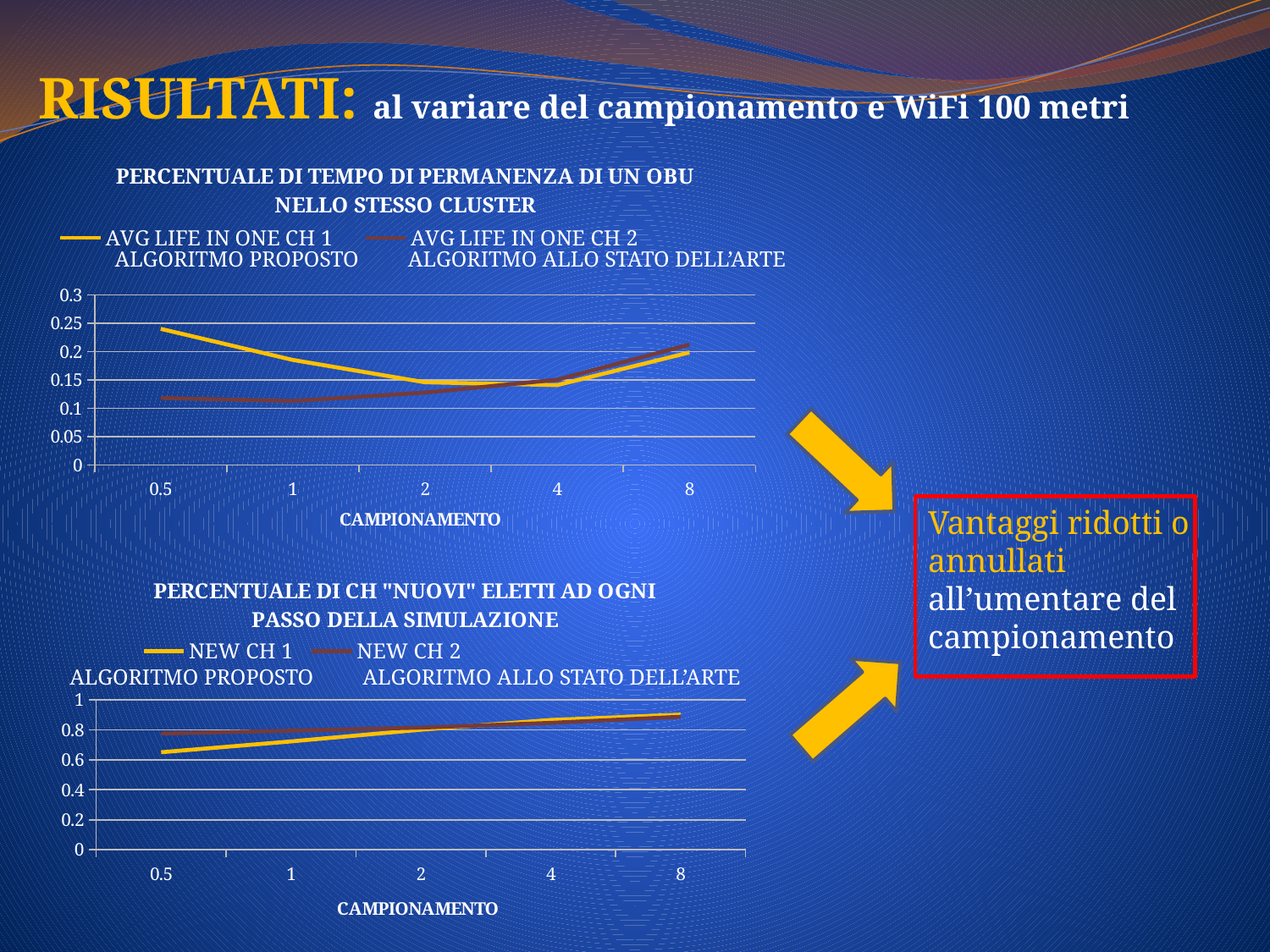
In the bottom chart (PERCENTUALE DI CH "NUOVI" ELETTI AD OGNI PASSO DELLA SIMULAZIONE), which series has the higher value at CAMPIONAMENTO 0.5? NEW CH 2 What is the x-axis title of the bottom chart (PERCENTUALE DI CH "NUOVI" ELETTI AD OGNI PASSO DELLA SIMULAZIONE)? CAMPIONAMENTO In the top chart (PERCENTUALE DI TEMPO DI PERMANENZA DI UN OBU NELLO STESSO CLUSTER), which series has the higher value at CAMPIONAMENTO 0.5? AVG LIFE IN ONE CH 1 ALGORITMO PROPOSTO In the top chart (PERCENTUALE DI TEMPO DI PERMANENZA DI UN OBU NELLO STESSO CLUSTER), at which CAMPIONAMENTO value does AVG LIFE IN ONE CH 1 ALGORITMO PROPOSTO reach its highest value? 0.5 In the top chart (PERCENTUALE DI TEMPO DI PERMANENZA DI UN OBU NELLO STESSO CLUSTER), is the value of AVG LIFE IN ONE CH 1 ALGORITMO PROPOSTO at CAMPIONAMENTO 0.5 greater or less than 0.2? greater In the bottom chart (PERCENTUALE DI CH "NUOVI" ELETTI AD OGNI PASSO DELLA SIMULAZIONE), is the value of NEW CH 1 at CAMPIONAMENTO 0.5 greater or less than 0.8? less In the top chart (PERCENTUALE DI TEMPO DI PERMANENZA DI UN OBU NELLO STESSO CLUSTER), is the value of AVG LIFE IN ONE CH 2 ALGORITMO ALLO STATO DELL'ARTE at CAMPIONAMENTO 0.5 greater or less than 0.15? less In the top chart (PERCENTUALE DI TEMPO DI PERMANENZA DI UN OBU NELLO STESSO CLUSTER), how many series does the legend list? 2 In the bottom chart (PERCENTUALE DI CH "NUOVI" ELETTI AD OGNI PASSO DELLA SIMULAZIONE), does the NEW CH 1 series rise or fall as CAMPIONAMENTO increases? rises In the top chart (PERCENTUALE DI TEMPO DI PERMANENZA DI UN OBU NELLO STESSO CLUSTER), how many CAMPIONAMENTO values are shown on the x axis? 5 What type of chart is the top chart titled "PERCENTUALE DI TEMPO DI PERMANENZA DI UN OBU NELLO STESSO CLUSTER"? line chart